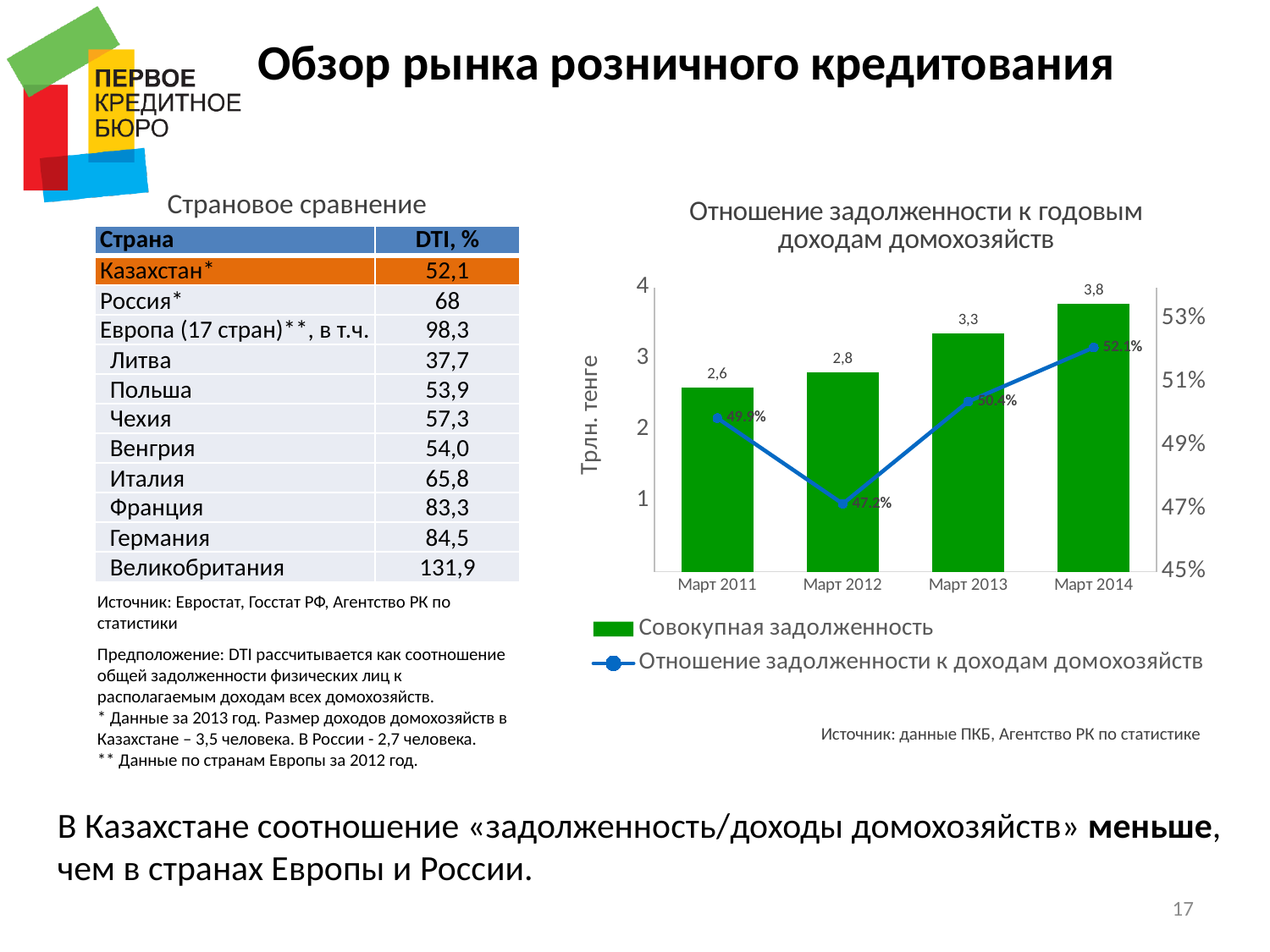
What is the difference in Совокупная задолженность between Март 2014 and Март 2011? 1,2 In which period is Отношение задолженности к доходам домохозяйств the lowest? Март 2012 In which period is Совокупная задолженность the highest? Март 2014 How many periods are shown on the x axis of the chart? 4 How many series does the chart legend list? 2 What is the value of Совокупная задолженность for Март 2011? 2,6 What type of chart is shown on the slide? Combined bar and line chart In which period is Совокупная задолженность the lowest? Март 2011 Which is larger: Совокупная задолженность in Март 2012 or in Март 2013? Март 2013 What is the value of Совокупная задолженность for Март 2013? 3,3 What is the value of Совокупная задолженность for Март 2014? 3,8 Does Совокупная задолженность rise or fall from Март 2011 to Март 2014? Rises